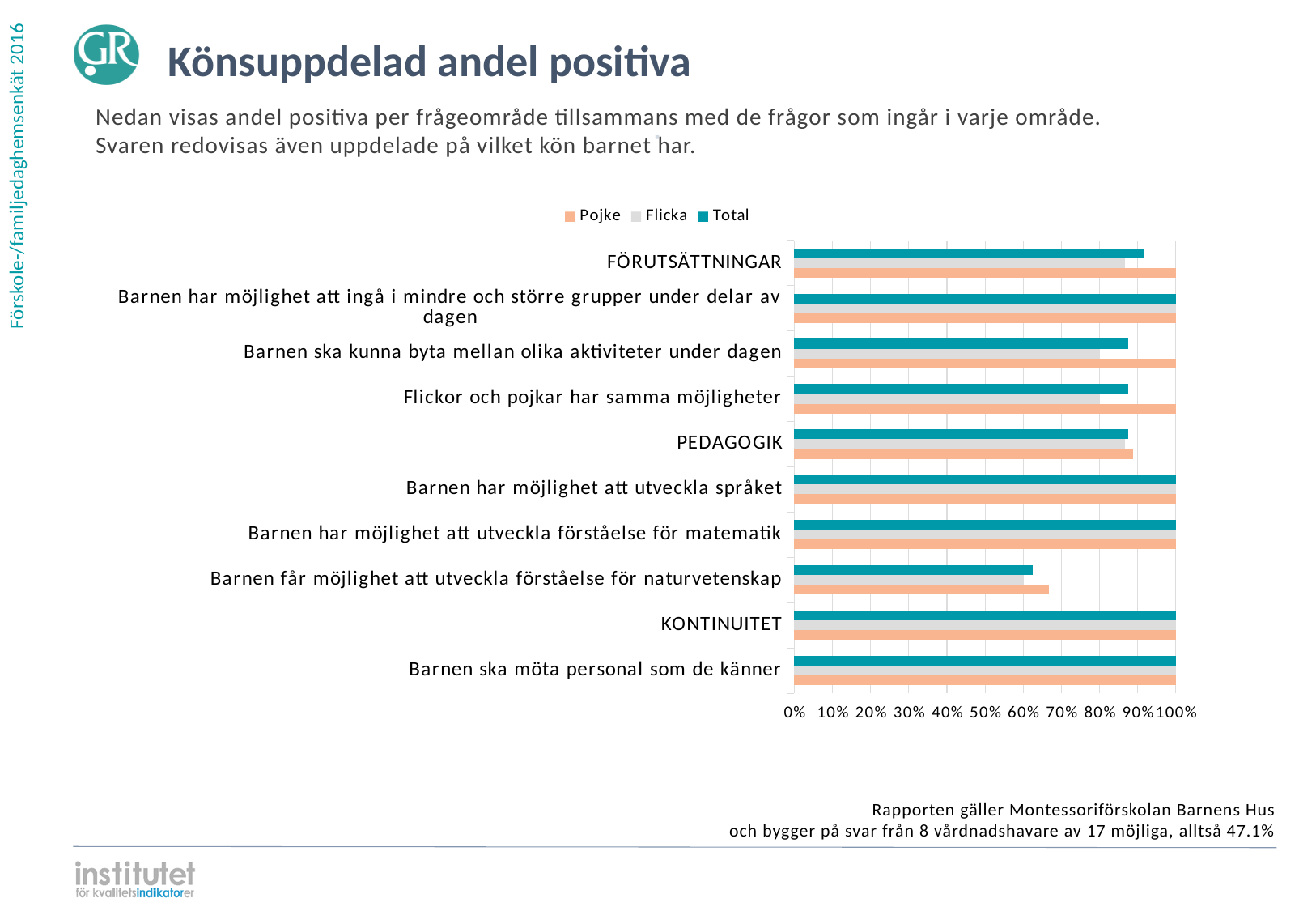
For 'Barnen får möjlighet att utveckla förståelse för naturvetenskap', which is larger, the Pojke value or the Flicka value? Pojke What are the series names listed in the legend? Pojke, Flicka, Total Which category has the lowest Total value? Barnen får möjlighet att utveckla förståelse för naturvetenskap What kind of chart is shown on the slide? bar chart Is the Pojke value for 'Barnen får möjlighet att utveckla förståelse för naturvetenskap' greater or less than 60%? greater How many series does the legend list? 3 Is the Flicka value for FÖRUTSÄTTNINGAR greater or less than 80%? greater Is the Total value for 'Barnen får möjlighet att utveckla förståelse för naturvetenskap' greater or less than 70%? less For FÖRUTSÄTTNINGAR, which is larger, the Pojke value or the Flicka value? Pojke What is the title of the slide? Könsuppdelad andel positiva How many categories are shown on the vertical axis of the chart? 10 What is the Pojke value for 'Barnen ska möta personal som de känner'? 100%